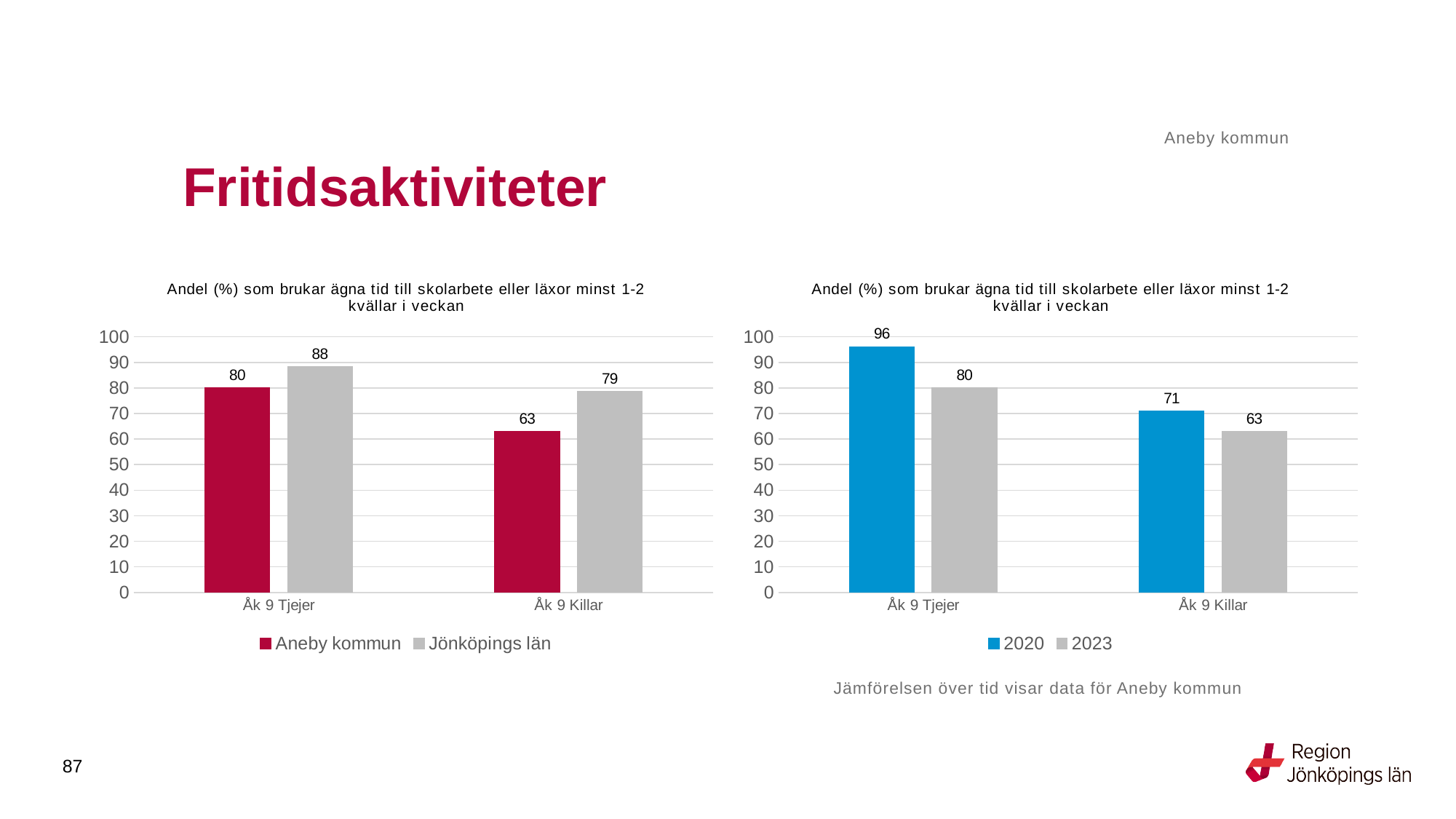
In the right chart, what is the value for 2023 for Åk 9 Killar? 63 In the right chart, what is the difference between 2020 and 2023 for Åk 9 Killar? 8 In the left chart, what is the value for Jönköpings län for Åk 9 Killar? 79 In the left chart, which bar is the lowest? Aneby kommun, Åk 9 Killar In the left chart, which is larger for Åk 9 Killar: Aneby kommun or Jönköpings län? Jönköpings län In the right chart, which bar is the highest? 2020, Åk 9 Tjejer How many categories are shown on the x axis of the left chart? 2 In the right chart, what is the value for 2020 for Åk 9 Tjejer? 96 How many series does the legend of the right chart list? 2 In the left chart, what is the difference between Jönköpings län and Aneby kommun for Åk 9 Tjejer? 8 In the left chart, what is the value for Aneby kommun for Åk 9 Tjejer? 80 What kind of chart is the right chart? Bar chart